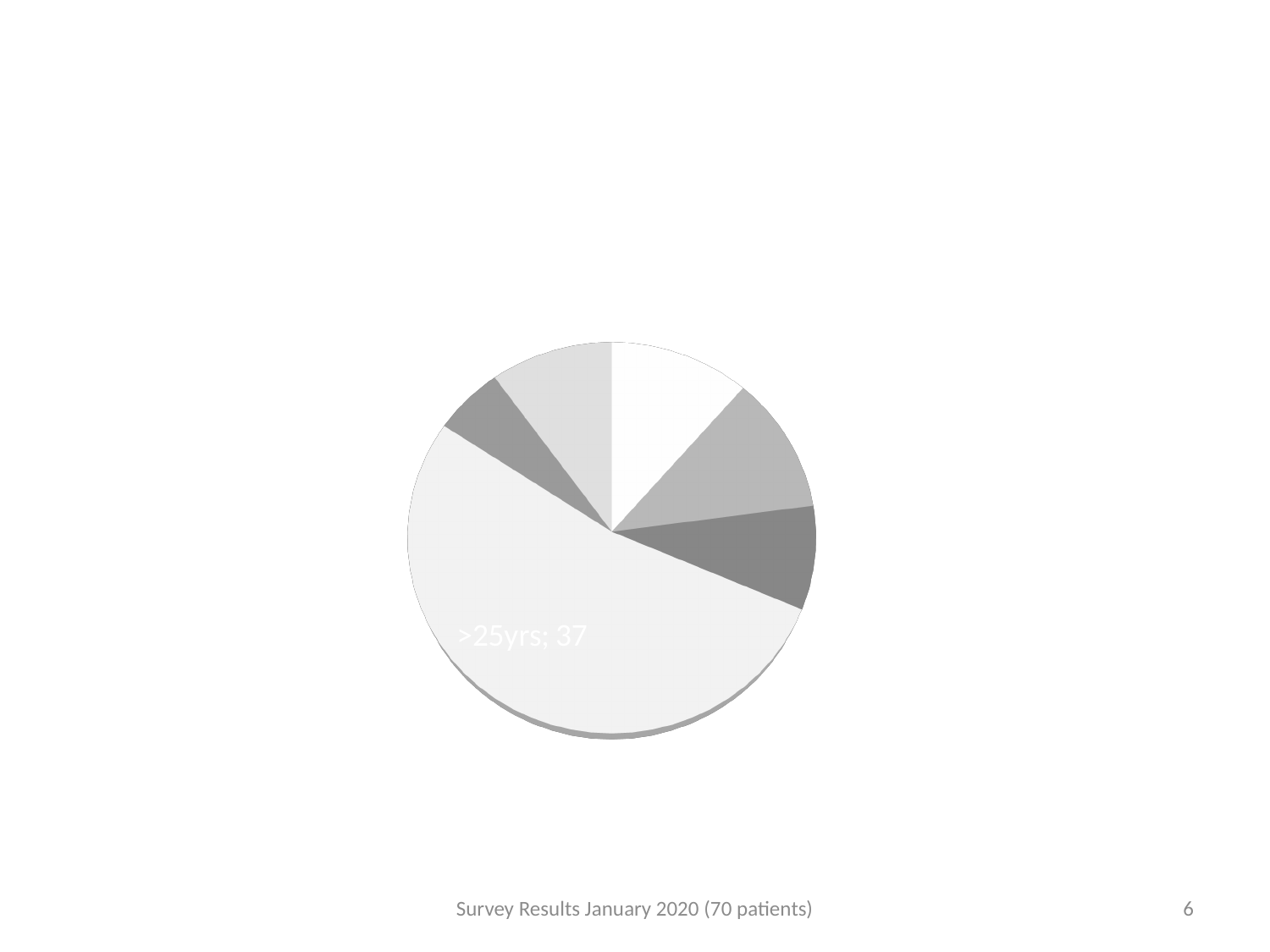
How many slices does the pie chart have? 6 Which slice of the pie chart has a data label printed on it? >25yrs What kind of chart is shown on the slide? pie chart Which slice of the pie chart is the largest? >25yrs What value is shown for the >25yrs slice of the pie chart? 37